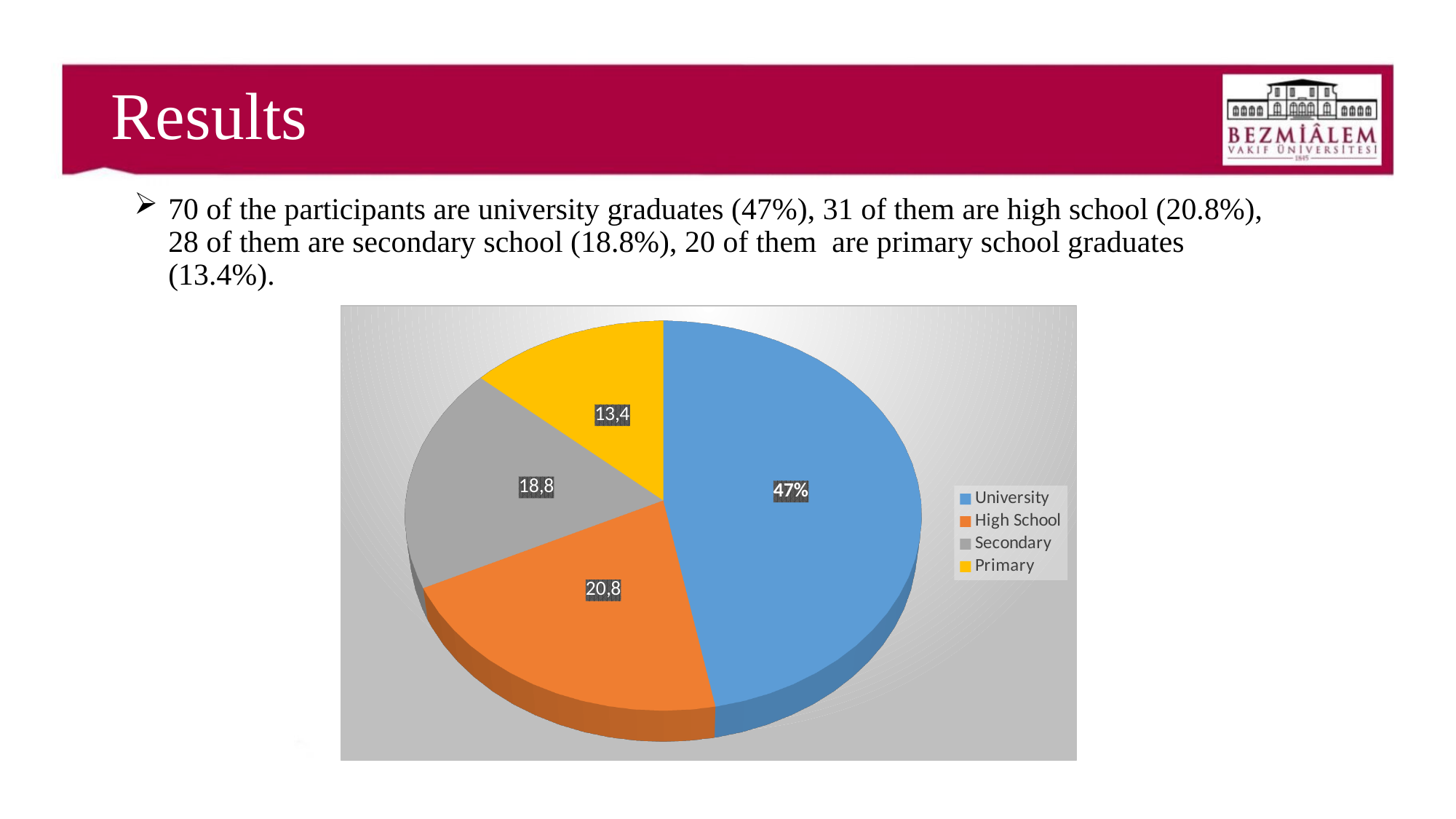
What kind of chart is shown on the slide? pie chart What value is labelled on the Primary slice of the pie chart? 13,4 What value is labelled on the Secondary slice of the pie chart? 18,8 What is the difference between the labelled values of the High School and Primary slices? 7,4 Which category has the smallest slice of the pie chart? Primary What value is labelled on the High School slice of the pie chart? 20,8 What colour is the University slice in the pie chart? blue Which category has the largest slice of the pie chart? University How many slices does the pie chart have? 4 How many entries does the legend of the pie chart list? 4 Which slice is larger in the pie chart, High School or Secondary? High School What value is labelled on the University slice of the pie chart? 47%